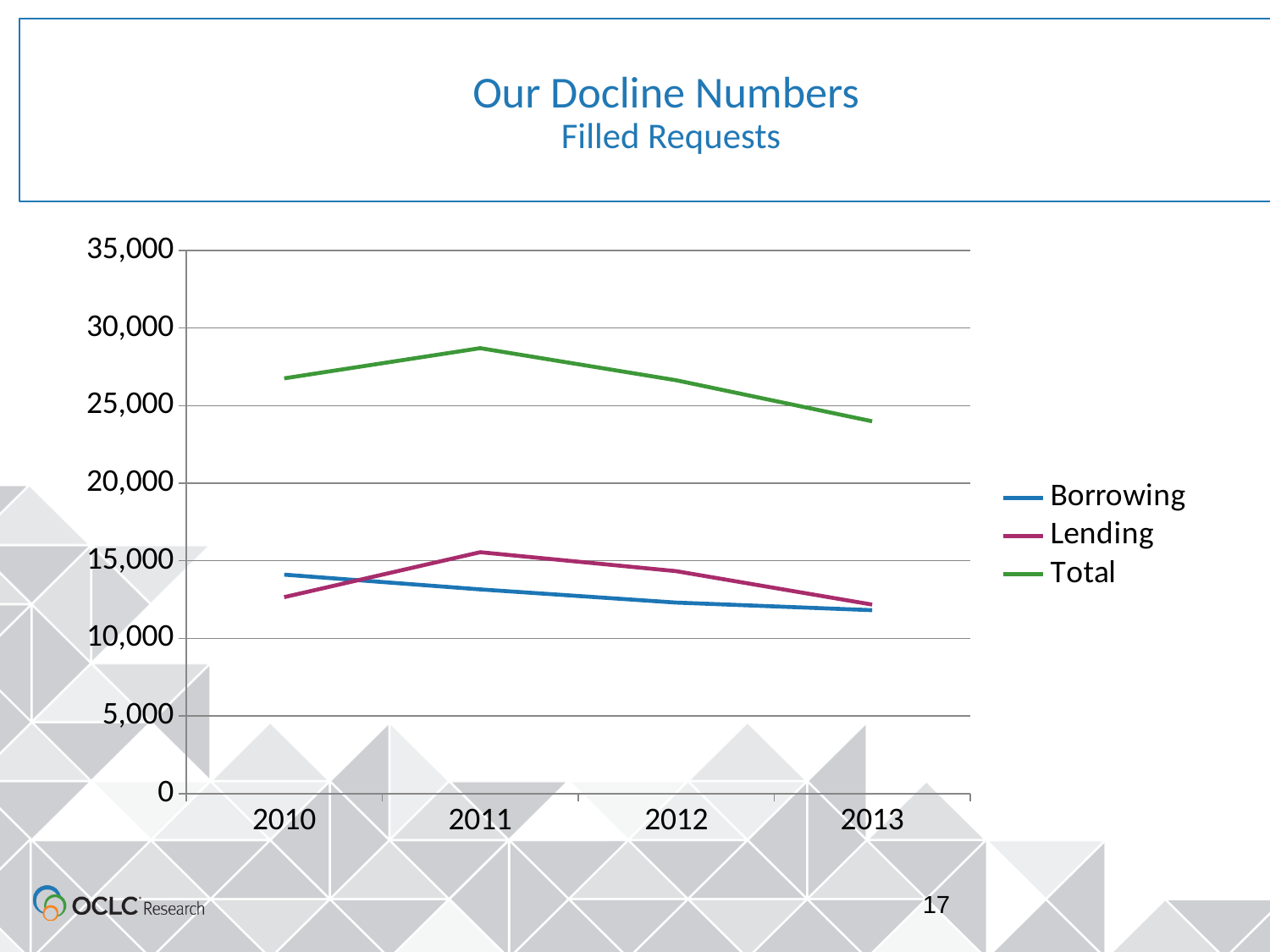
Is the Borrowing value for 2013 greater or less than 15,000? less How many series does the legend list? 3 In which year is the Borrowing series at its highest? 2010 In which year is the Total line at its highest? 2011 In which year does the Lending series reach its highest value? 2011 Is the Total value for 2011 greater or less than 25,000? greater In 2010, which is higher, Borrowing or Lending? Borrowing How many years are plotted along the x axis? 4 In which year is the Total line at its lowest? 2013 Does the Borrowing series rise or fall from 2010 to 2013? fall What kind of chart is shown on the slide? line chart Is the Total value for 2013 greater or less than 25,000? less